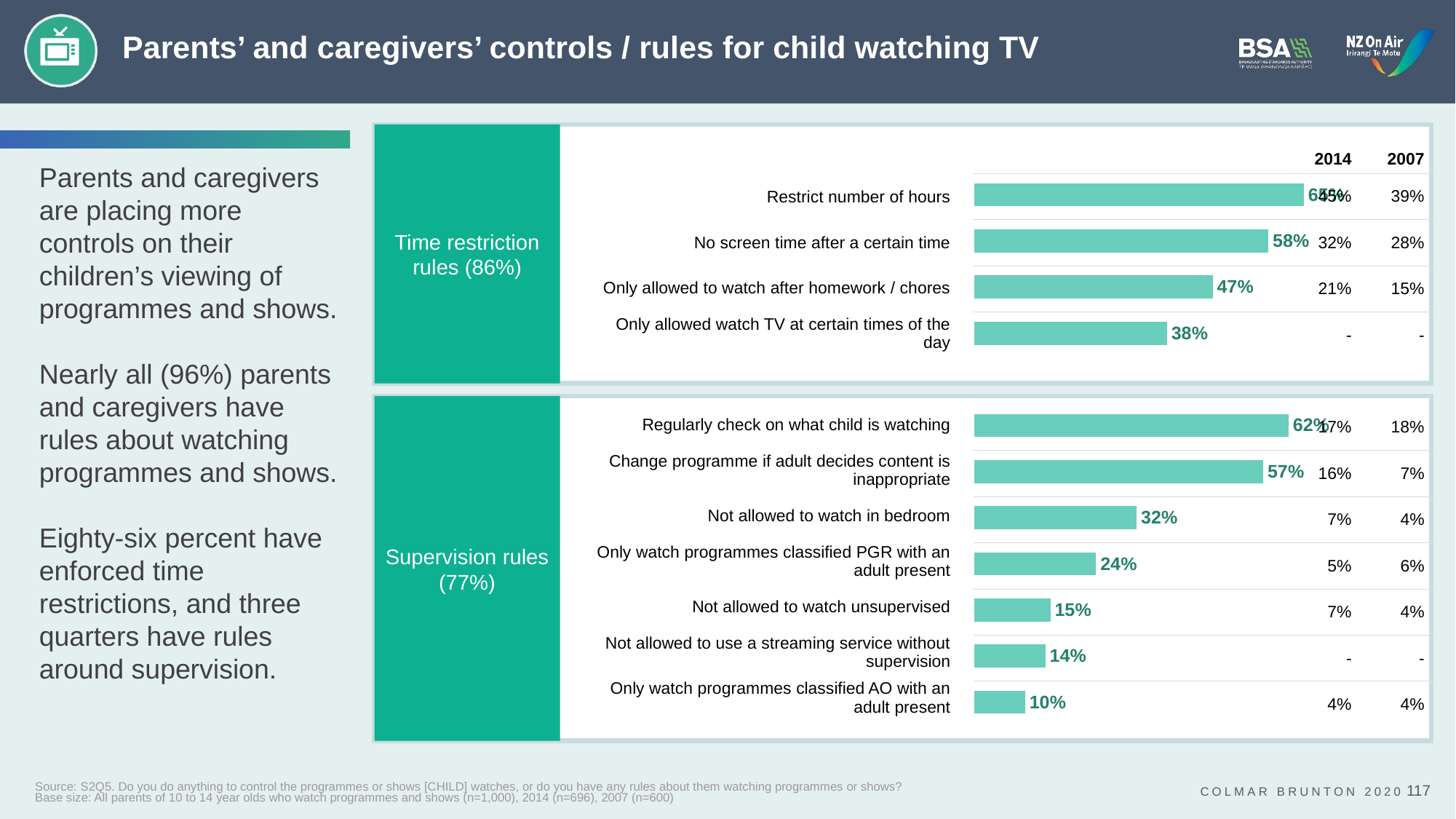
In the Supervision rules chart, which category has the highest value? Regularly check on what child is watching What type of chart is used for the Time restriction rules? Bar chart In the Time restriction rules chart, which category has the lowest value? Only allowed watch TV at certain times of the day In the Time restriction rules chart, what is the difference between 'No screen time after a certain time' and 'Only allowed to watch after homework / chores'? 11 percentage points In the Supervision rules chart, what is the value for 'Not allowed to watch in bedroom'? 32% In the Supervision rules chart, what is the value for 'Only watch programmes classified AO with an adult present'? 10% In the Supervision rules chart, which is larger: 'Not allowed to watch unsupervised' or 'Not allowed to watch in bedroom'? Not allowed to watch in bedroom In the Time restriction rules chart, what is the value for 'Only allowed to watch after homework / chores'? 47% In the Supervision rules chart, what is the value for 'Only watch programmes classified PGR with an adult present'? 24% How many categories are plotted in the Supervision rules chart? 7 In the Time restriction rules chart, what is the value for 'Only allowed watch TV at certain times of the day'? 38% In the Time restriction rules chart, what is the value for 'No screen time after a certain time'? 58%